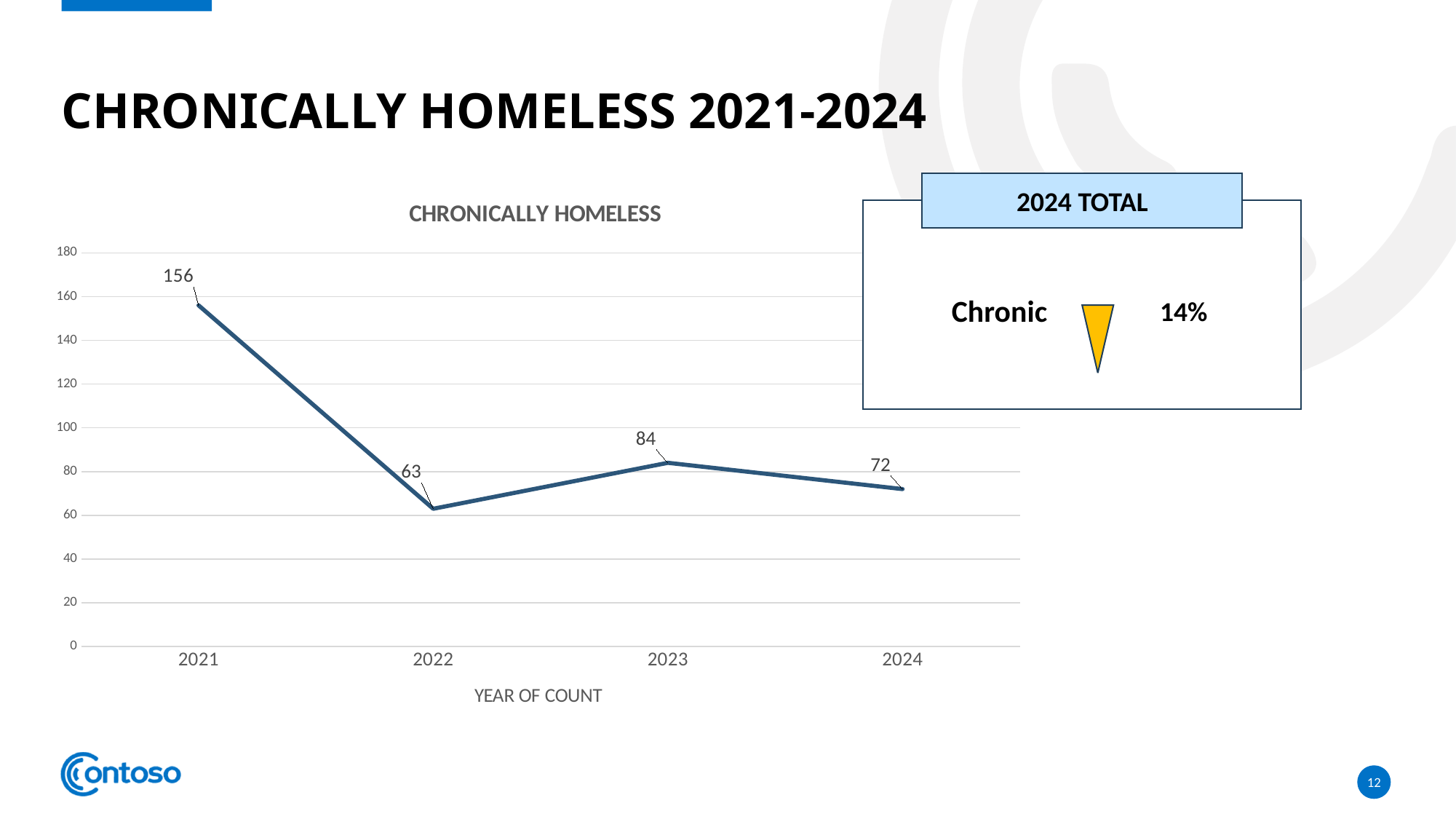
What kind of chart is the Chronically Homeless chart? line chart Which year has the highest value in the Chronically Homeless chart? 2021 Which year has the lowest value in the Chronically Homeless chart? 2022 Which is larger in the Chronically Homeless chart, the value for 2023 or the value for 2024? 2023 How many years are plotted in the Chronically Homeless chart? 4 What is the difference between the 2021 and 2022 values in the Chronically Homeless chart? 93 What is the value for 2022 in the Chronically Homeless chart? 63 What is the x-axis title of the Chronically Homeless chart? YEAR OF COUNT Is the value for 2021 in the Chronically Homeless chart greater or less than 140? greater What is the value for 2021 in the Chronically Homeless chart? 156 What is the value for 2023 in the Chronically Homeless chart? 84 What is the value for 2024 in the Chronically Homeless chart? 72